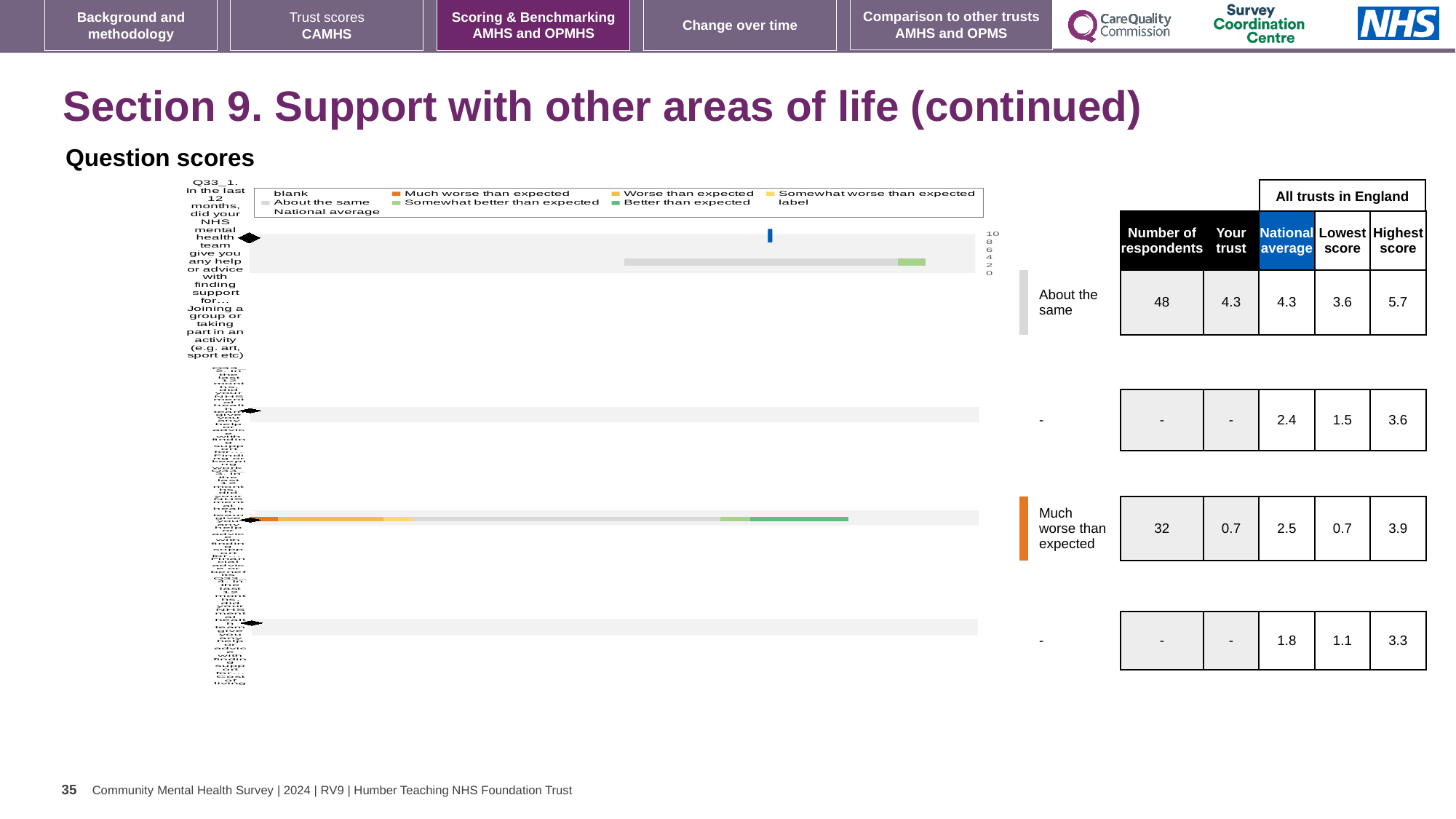
What is the 'Your trust' score for Q33_1 (help or advice with joining a group or taking part in an activity)? 4.3 What is the national average score for Q33_1 (joining a group or taking part in an activity)? 4.3 What is the highest score among all trusts in England for Q33_1 (joining a group or taking part in an activity)? 5.7 What kind of chart is shown under 'Question scores'? Bar chart What is the lowest score among all trusts in England for Q33_1 (joining a group or taking part in an activity)? 3.6 How many question rows are shown in the table beside the chart? 4 What is the difference between the highest score (5.7) and the lowest score (3.6) for Q33_1? 2.1 In the row marked 'Much worse than expected', what is the 'Your trust' score? 0.7 In the row marked 'Much worse than expected', how many respondents are recorded? 32 How many respondents are recorded for Q33_1 (joining a group or taking part in an activity)? 48 Which benchmark category is shown for Q33_1 (joining a group or taking part in an activity)? About the same How many entries does the chart legend list? 9